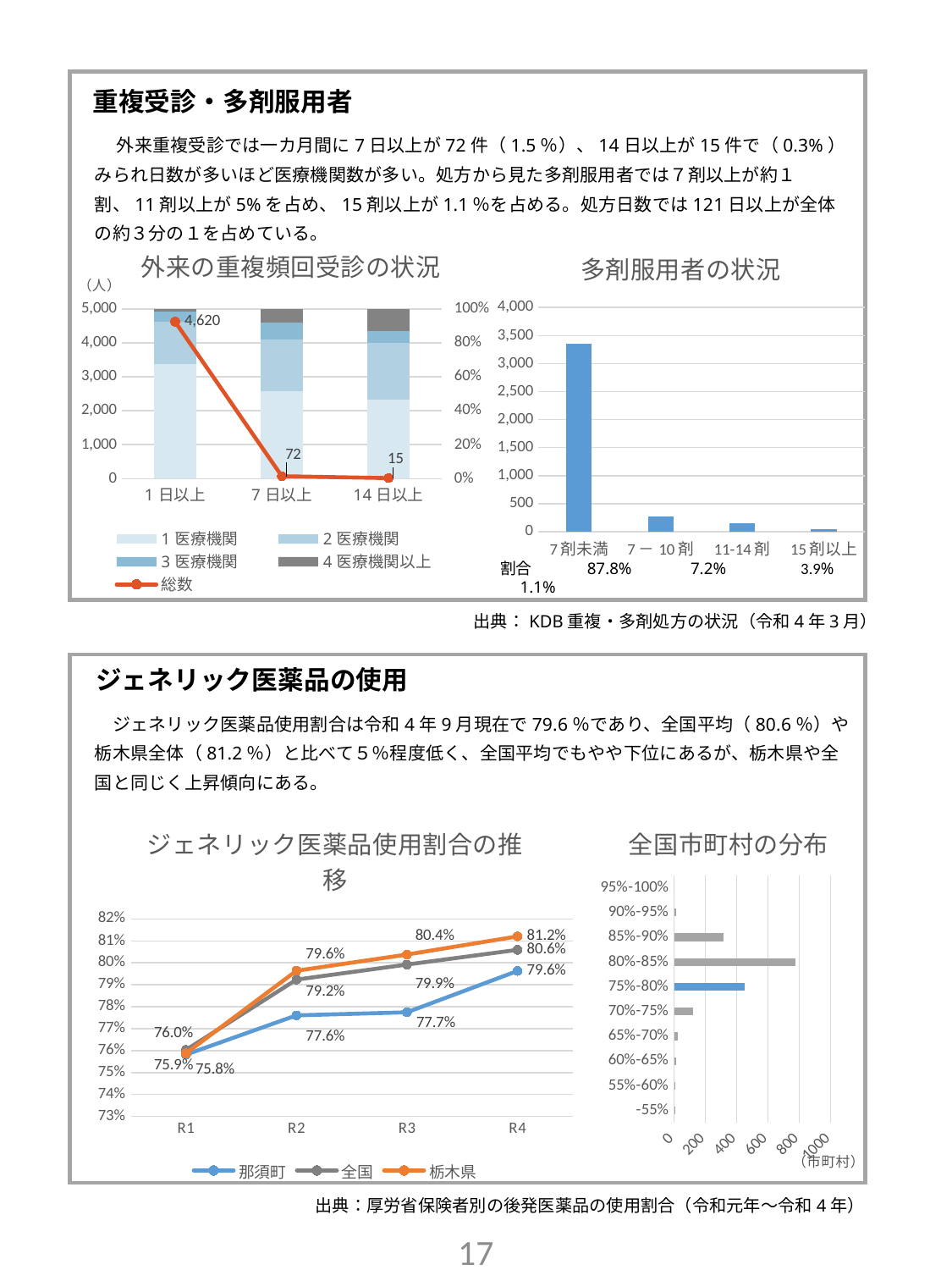
In the chart titled 多剤服用者の状況, is the value for 7剤未満 greater or less than 3,000? greater In the chart titled 多剤服用者の状況, which category has the highest bar? 7剤未満 In the chart titled 多剤服用者の状況, how many categories are shown on the x axis? 4 In the chart titled ジェネリック医薬品使用割合の推移, what is the difference between 栃木県 and 全国 at R4? 0.6% In the chart titled 外来の重複頻回受診の状況, what is the difference between the 総数 values for 7日以上 and 14日以上? 57 In the chart titled 外来の重複頻回受診の状況, what is the 総数 value for 7日以上? 72 In the chart titled 外来の重複頻回受診の状況, how many entries does the legend list? 5 In the chart titled 全国市町村の分布, which category has the longest bar? 80%-85% In the chart titled ジェネリック医薬品使用割合の推移, what is the value for 那須町 at R4? 79.6% In the chart titled ジェネリック医薬品使用割合の推移, which is larger at R2: 全国 or 那須町? 全国 In the chart titled ジェネリック医薬品使用割合の推移, does the 那須町 line rise or fall from R1 to R4? rise In the chart titled 外来の重複頻回受診の状況, what is the 総数 value for 1日以上? 4,620